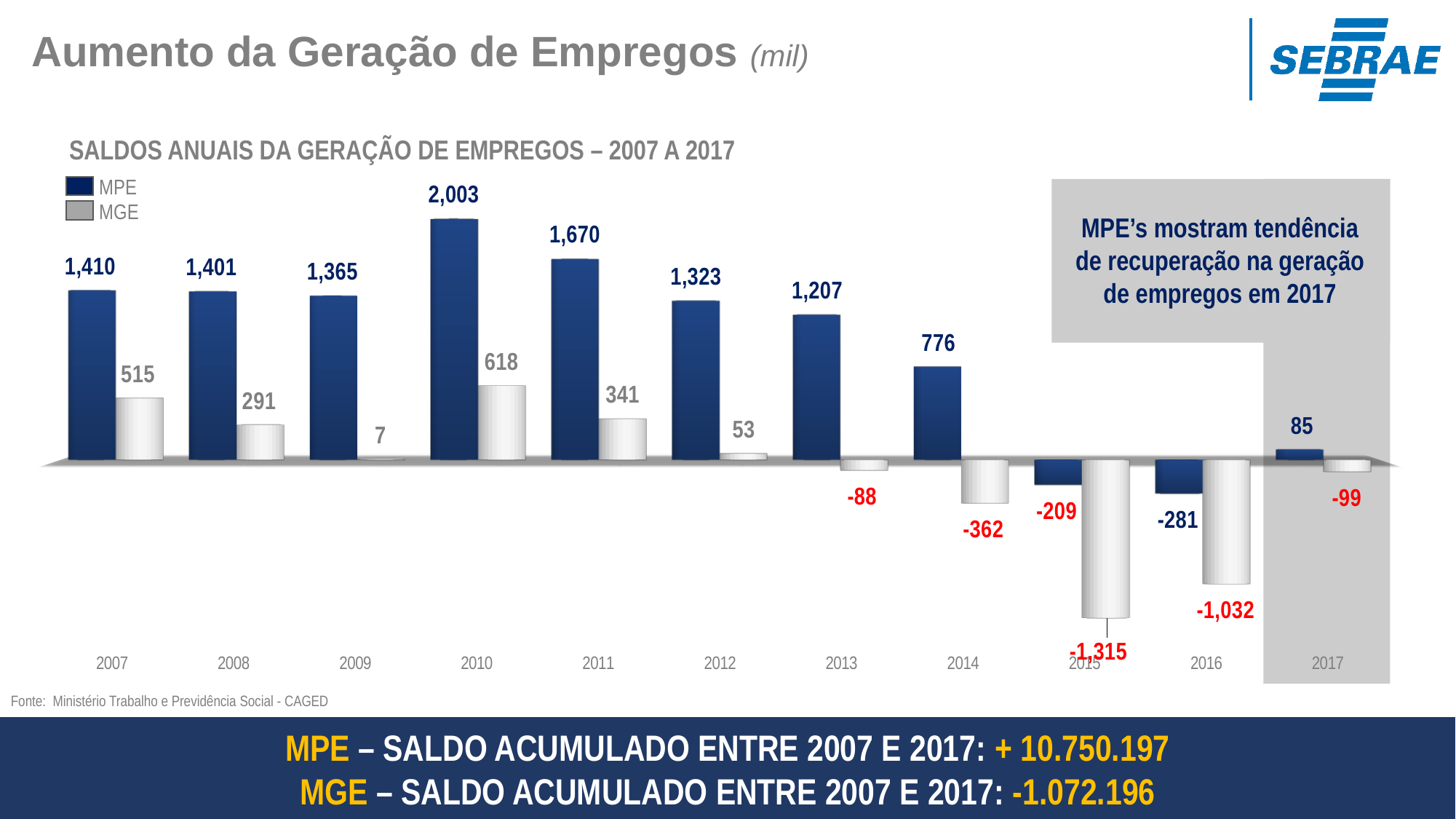
In which year is the MGE value lowest? 2015 Which is larger in 2014, the MPE value or the MGE value? MPE What is the MGE value for 2015? -1,315 What is the MPE value for 2017? 85 Does the MPE value rise or fall from 2010 to 2016? Fall How many series does the legend list? 2 What is the difference between the MPE and MGE values in 2010? 1,385 How many years are shown on the x axis? 11 What is the MPE value for 2010? 2,003 What kind of chart is shown on the slide? Bar chart In which year is the MPE value highest? 2010 What is the MGE value for 2009? 7